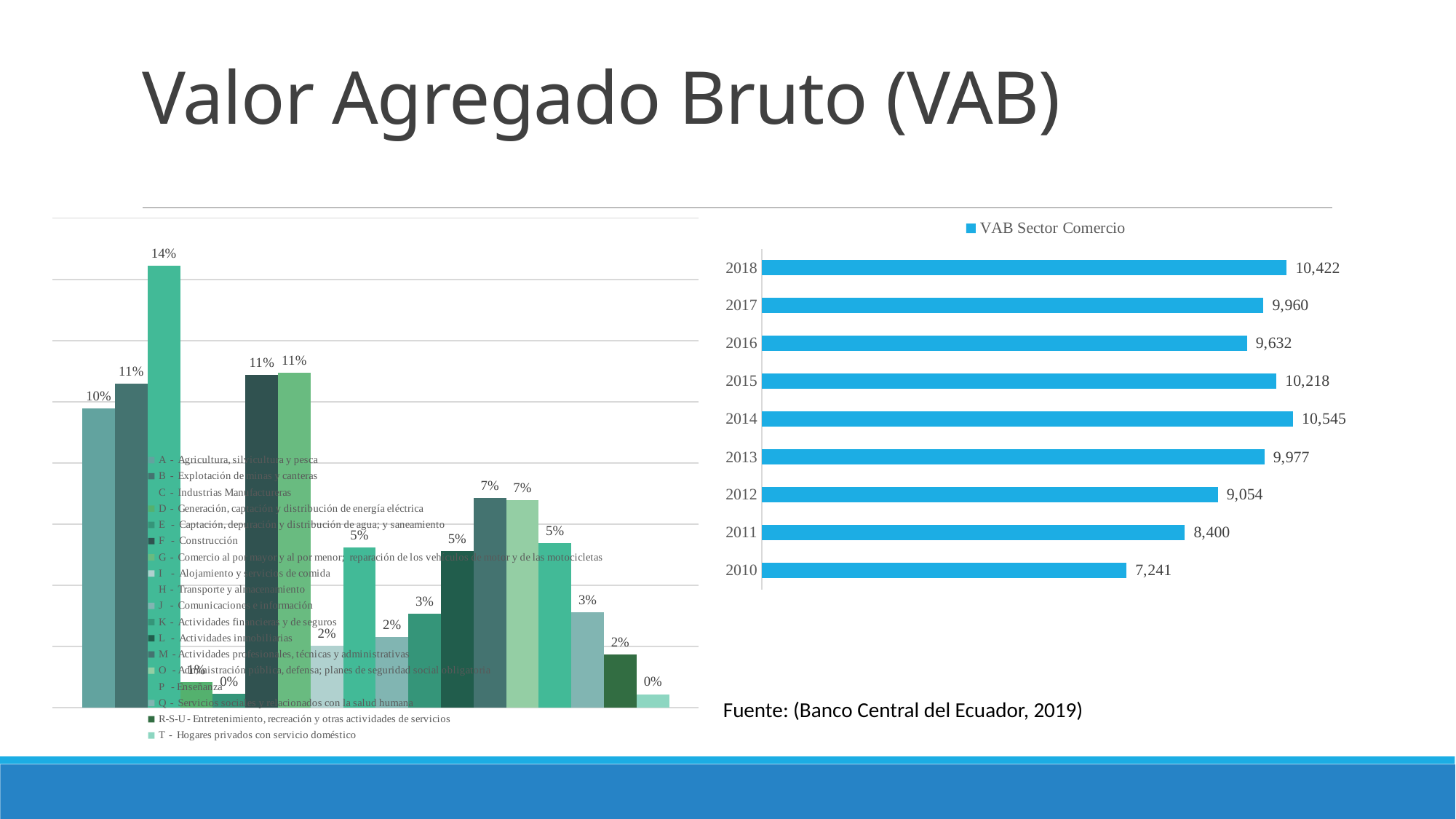
In the VAB Sector Comercio chart, what is the value for 2010? 7,241 How many years are shown in the VAB Sector Comercio chart? 9 In the VAB Sector Comercio chart, which year has the highest value? 2014 In the VAB Sector Comercio chart, what is the difference between the 2014 and 2010 values? 3,304 In the VAB Sector Comercio chart, which is larger, the value for 2015 or the value for 2016? 2015 In the VAB Sector Comercio chart, what is the difference between the 2018 and 2017 values? 462 In the VAB Sector Comercio chart, what is the value for 2018? 10,422 In the VAB Sector Comercio chart, what is the value for 2013? 9,977 In the VAB Sector Comercio chart, which year has the lowest value? 2010 How many series does the legend of the VAB Sector Comercio chart list? 1 In the chart on the left of the slide, what is the highest percentage value shown on a bar? 14% What kind of chart is the VAB Sector Comercio chart on the right? Bar chart